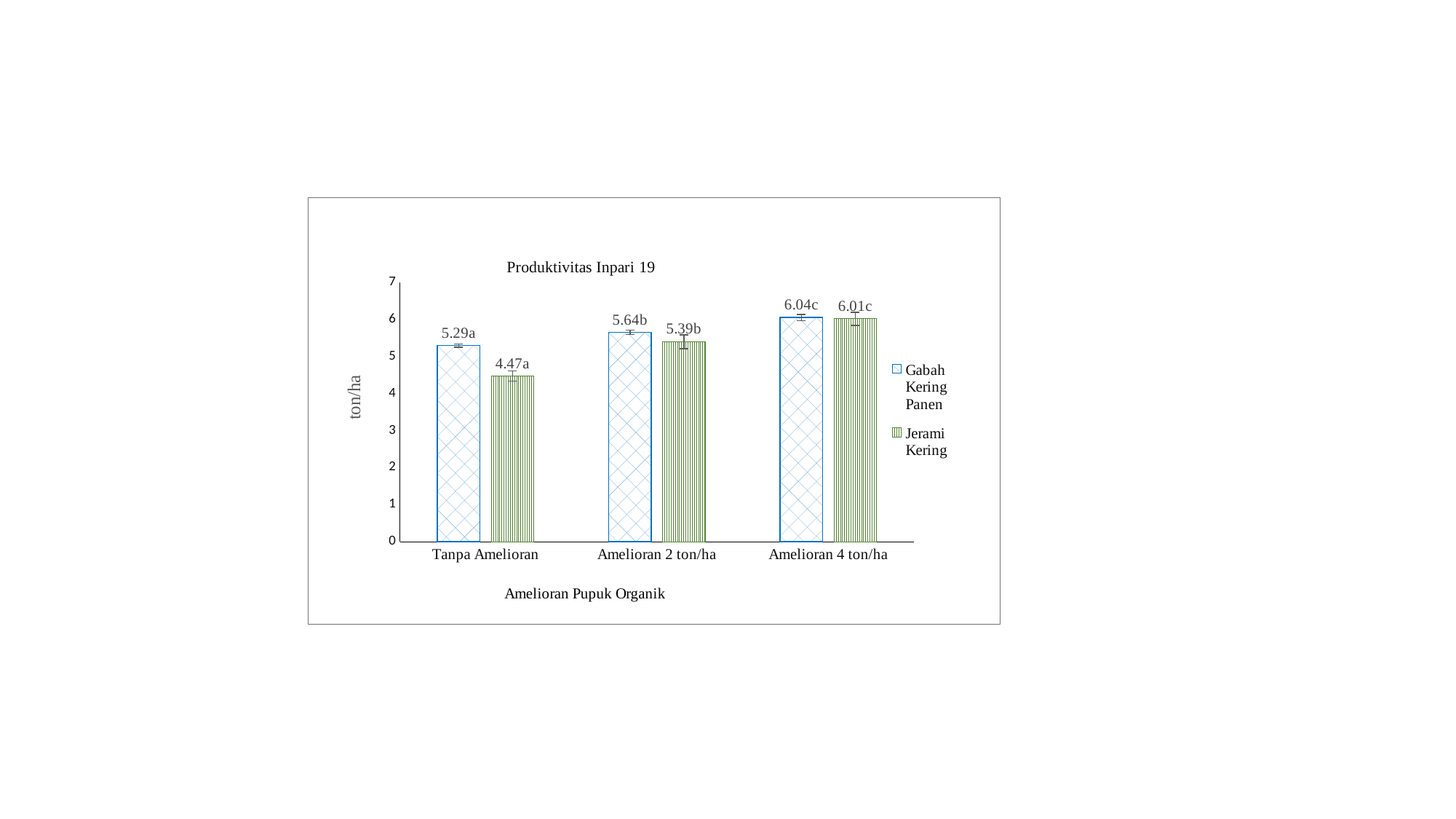
What is the title of the chart? Produktivitas Inpari 19 What kind of chart is shown on the slide? bar chart What is the difference between Gabah Kering Panen and Jerami Kering at Tanpa Amelioran? 0.82 How many categories are shown on the x axis? 3 Which category has the highest Gabah Kering Panen value? Amelioran 4 ton/ha Which is larger at Amelioran 2 ton/ha: Gabah Kering Panen or Jerami Kering? Gabah Kering Panen What is the data label for Jerami Kering at Amelioran 2 ton/ha? 5.39b What is the data label for Gabah Kering Panen at Tanpa Amelioran? 5.29a How many series does the legend list? 2 Do the Gabah Kering Panen values rise or fall from Tanpa Amelioran to Amelioran 4 ton/ha? rise Which category has the lowest Jerami Kering value? Tanpa Amelioran What is the data label for Gabah Kering Panen at Amelioran 4 ton/ha? 6.04c